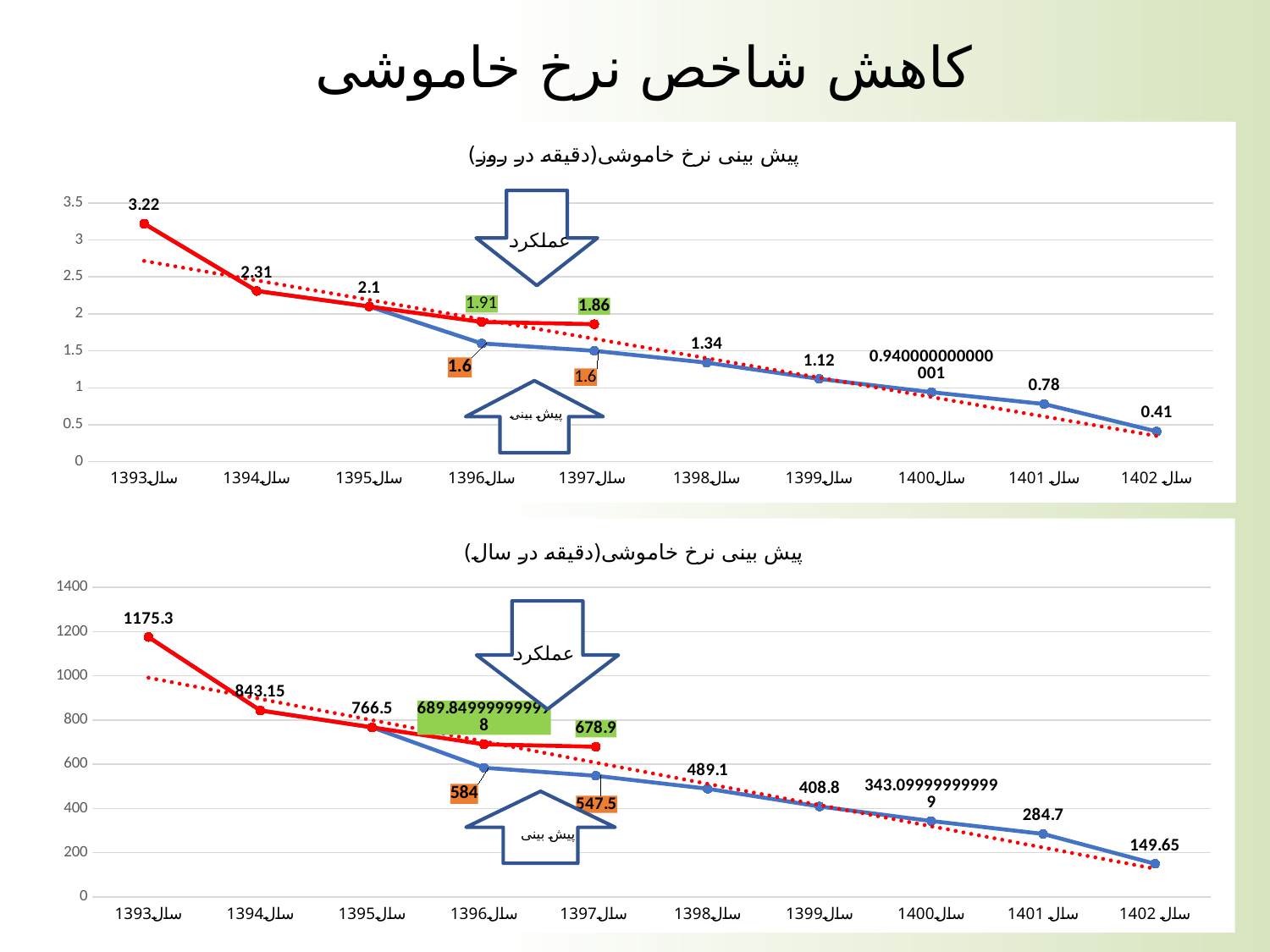
On the bottom chart (minutes per year), which is larger: the value for سال1398 or the value for سال1399? سال1398 How many years are shown on the x axis of the bottom chart? 10 On the top chart (minutes per day), what is the value labelled for سال1393? 3.22 On the top chart (minutes per day), what is the value labelled for سال1402? 0.41 On the top chart (minutes per day), what is the red (عملکرد) value labelled for سال1397? 1.86 On the top chart (minutes per day), which year has the highest value? سال1393 On the bottom chart (minutes per year), what is the value labelled for سال1393? 1175.3 On the bottom chart (minutes per year), which year has the lowest value? سال1402 On the top chart (minutes per day), what is the difference between the values for سال1393 and سال1394? 0.91 On the bottom chart (minutes per year), what is the value labelled for سال1401? 284.7 On the bottom chart (minutes per year), what is the blue (پیش بینی) value labelled for سال1397? 547.5 On the top chart (minutes per day), do the values rise or fall from سال1393 to سال1402? fall